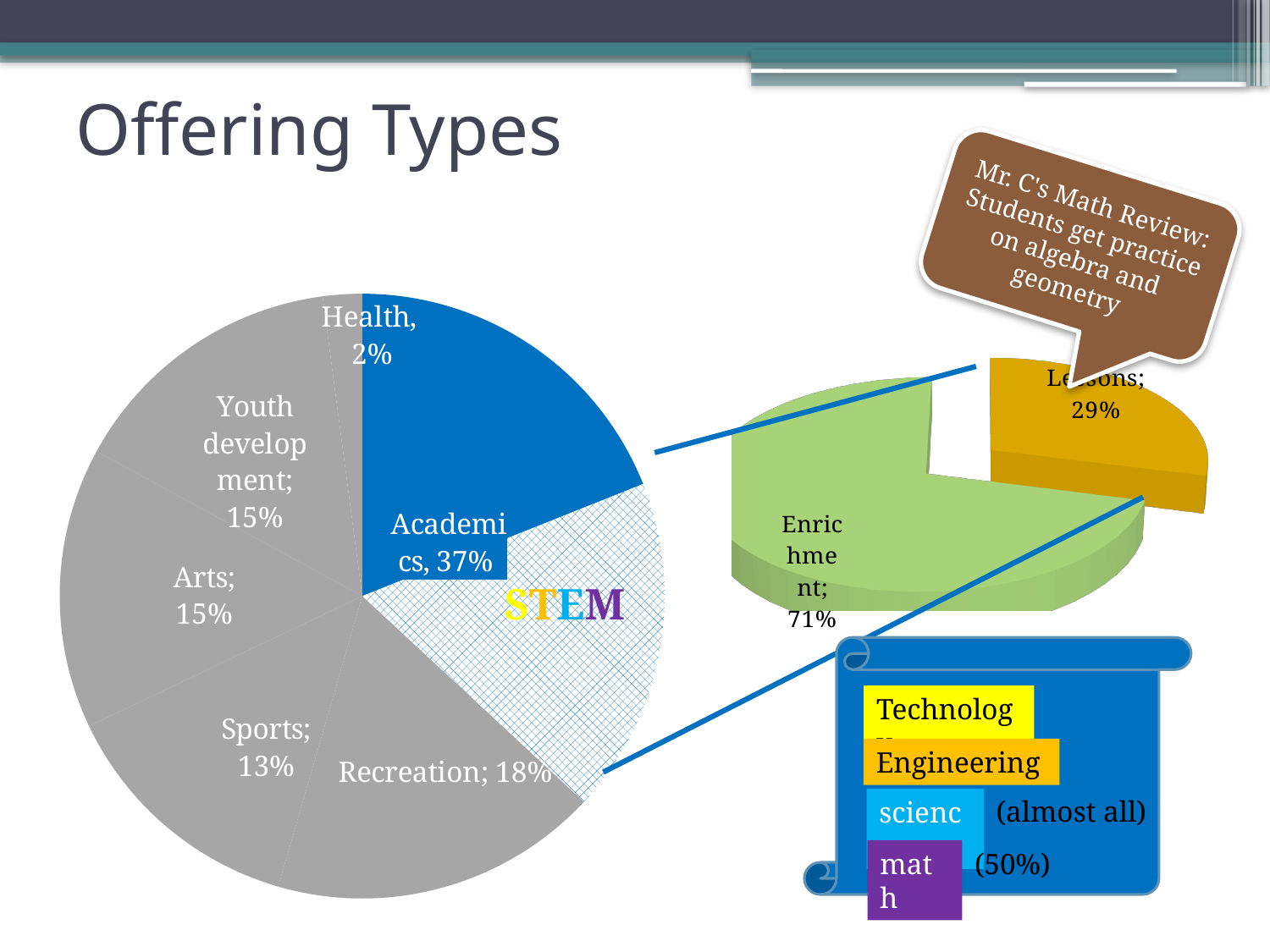
On the right pie chart, how many slices are there? 2 On the left pie chart, which has the larger share, Sports or Arts? Arts On the left pie chart, what percentage is shown for Academics? 37% On the left pie chart, which labeled category has the smallest share? Health What kind of chart is the large chart on the left of the slide? Pie chart On the left pie chart, what percentage is shown for Sports? 13% On the left pie chart, how many percentage points larger is Academics than Recreation? 19 percentage points On the left pie chart, what percentage is shown for Health? 2% On the right pie chart, what percentage is shown for Lessons? 29% On the left pie chart, what percentage is shown for Recreation? 18% On the left pie chart, which labeled category has the largest share? Academics On the right pie chart, what percentage is shown for Enrichment? 71%